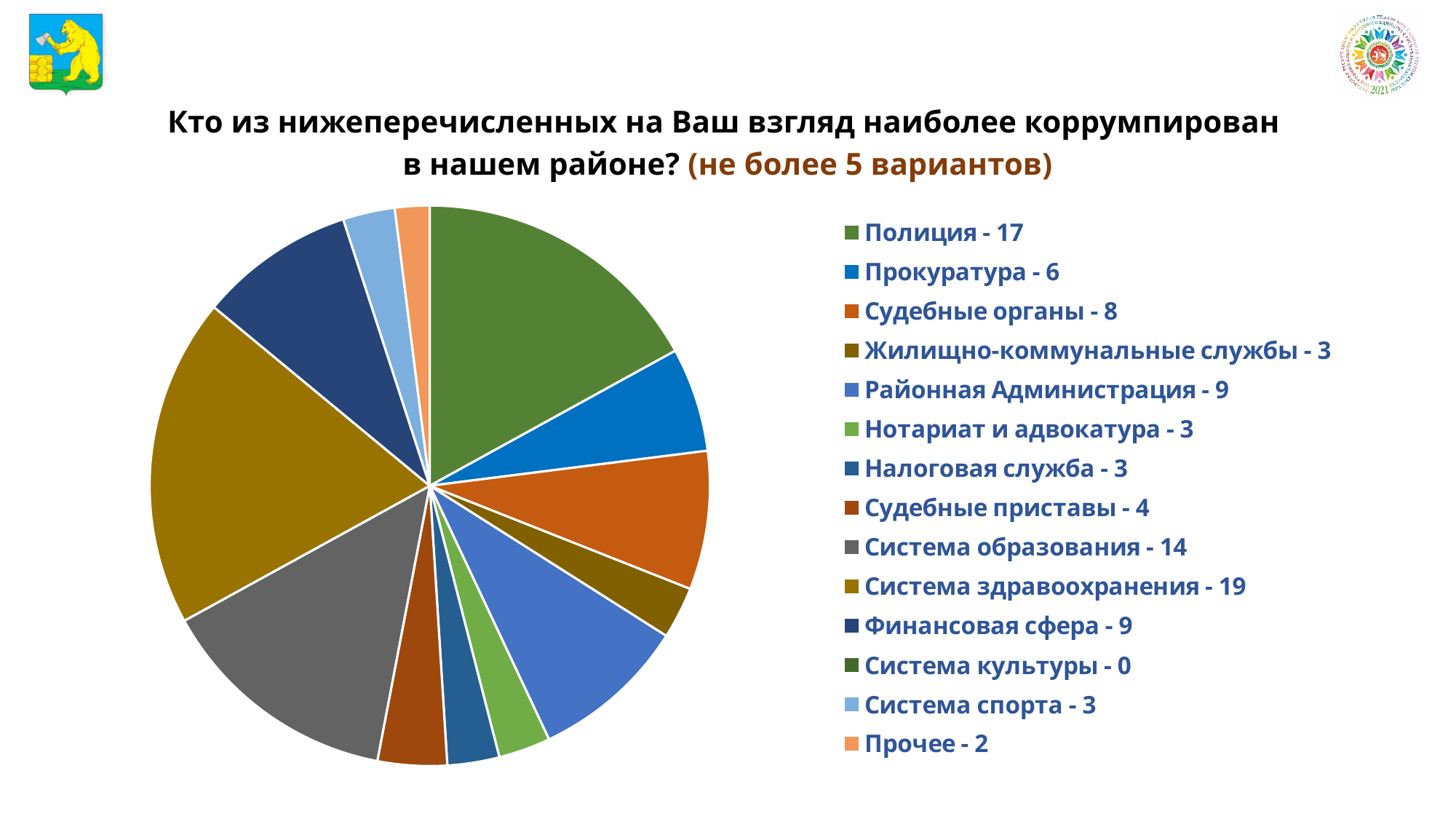
How many categories does the legend list? 14 What is the difference between the values for Система здравоохранения and Полиция? 2 Which is larger, the value for Судебные органы or the value for Прокуратура? Судебные органы What is the value for Судебные приставы? 4 What colour is the slice for Система здравоохранения? dark yellow (gold) What is the value for Система образования? 14 What share of the pie does Полиция represent, given the values sum to 100? 17% Which category has the highest value? Система здравоохранения What is the value for Полиция? 17 Which category has the lowest value? Система культуры What type of chart is shown on the slide? pie chart What is the difference between the values for Система образования and Районная Администрация? 5